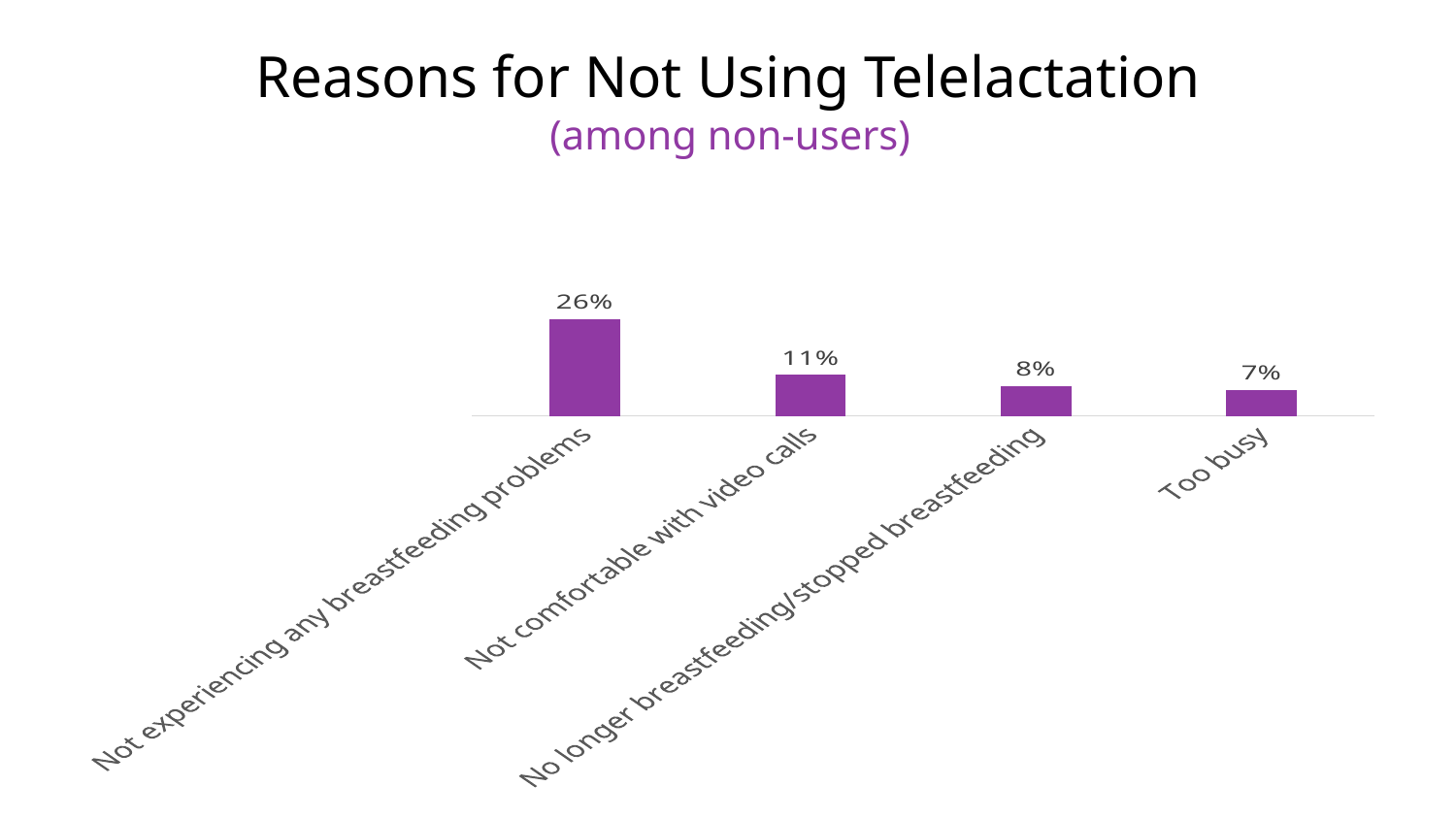
What percentage of non-users cited 'Not experiencing any breastfeeding problems' as a reason for not using telelactation? 26% What percentage of non-users said they were 'Too busy'? 7% Which reason has the lowest percentage? Too busy What is the difference between 'No longer breastfeeding/stopped breastfeeding' and 'Too busy'? 1% What is the value for 'No longer breastfeeding/stopped breastfeeding'? 8% What is the value for 'Not comfortable with video calls'? 11% Which reason has the highest percentage? Not experiencing any breastfeeding problems How many reasons (categories) are shown in the chart? 4 Do the values rise or fall from left to right across the categories? Fall Which is larger: the value for 'Not comfortable with video calls' or the value for 'Too busy'? Not comfortable with video calls What kind of chart is shown on the slide? Bar chart What is the difference between 'Not experiencing any breastfeeding problems' and 'Not comfortable with video calls'? 15%